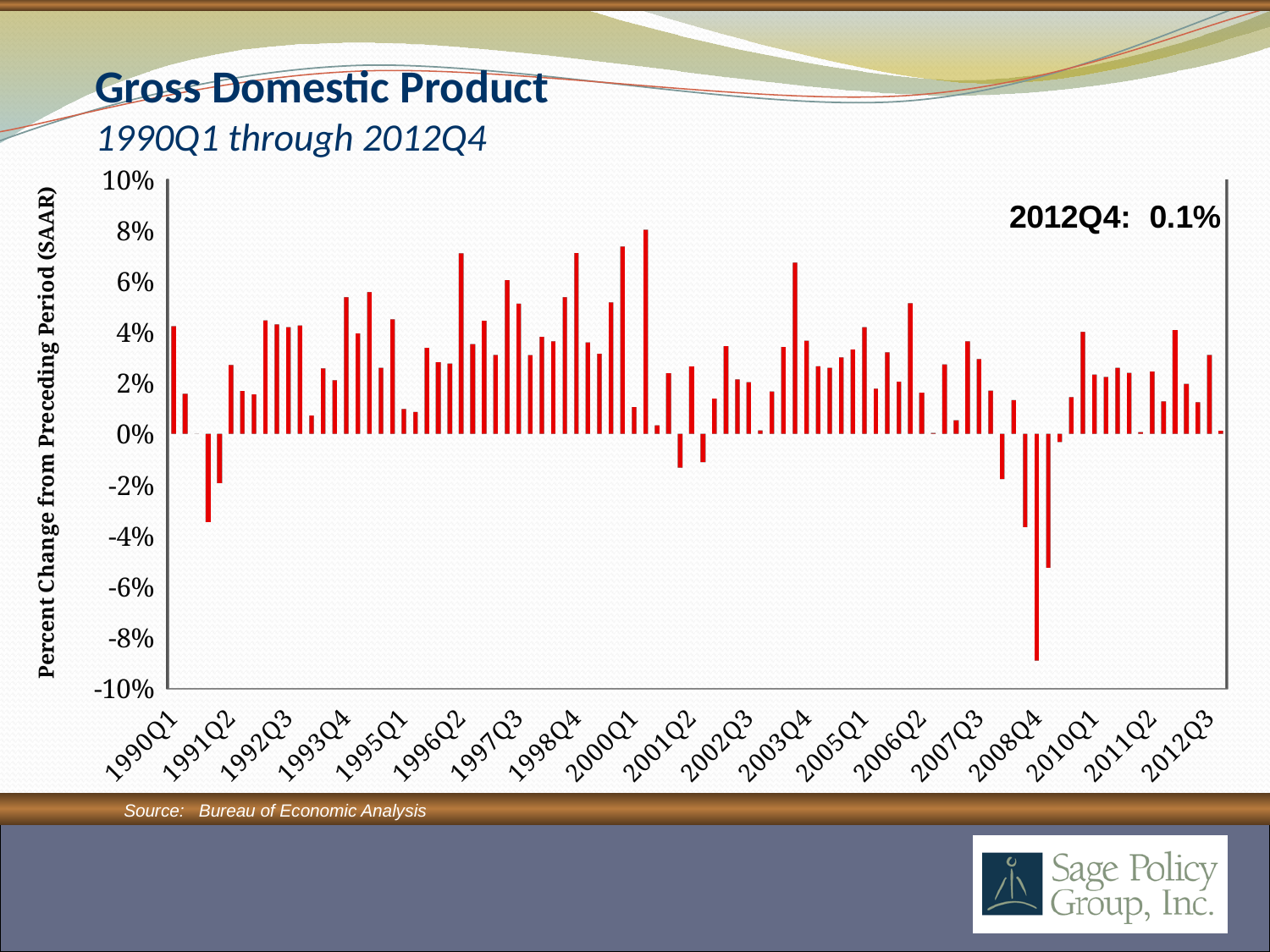
What is the lowest value shown on the vertical axis? -10% What is the label on the vertical axis? Percent Change from Preceding Period (SAAR) Is the value for 2012Q4 greater or less than 2%? less Is the lowest value on the chart greater or less than -8%? less What is the value shown for 2012Q4? 0.1% What kind of chart is used to show the GDP data? bar chart What period does the chart cover, according to the subtitle? 1990Q1 through 2012Q4 What is the title of the chart? Gross Domestic Product Is the value for 1990Q1 greater or less than 2%? greater How many data series are plotted on the chart? 1 What is the highest value shown on the vertical axis? 10%